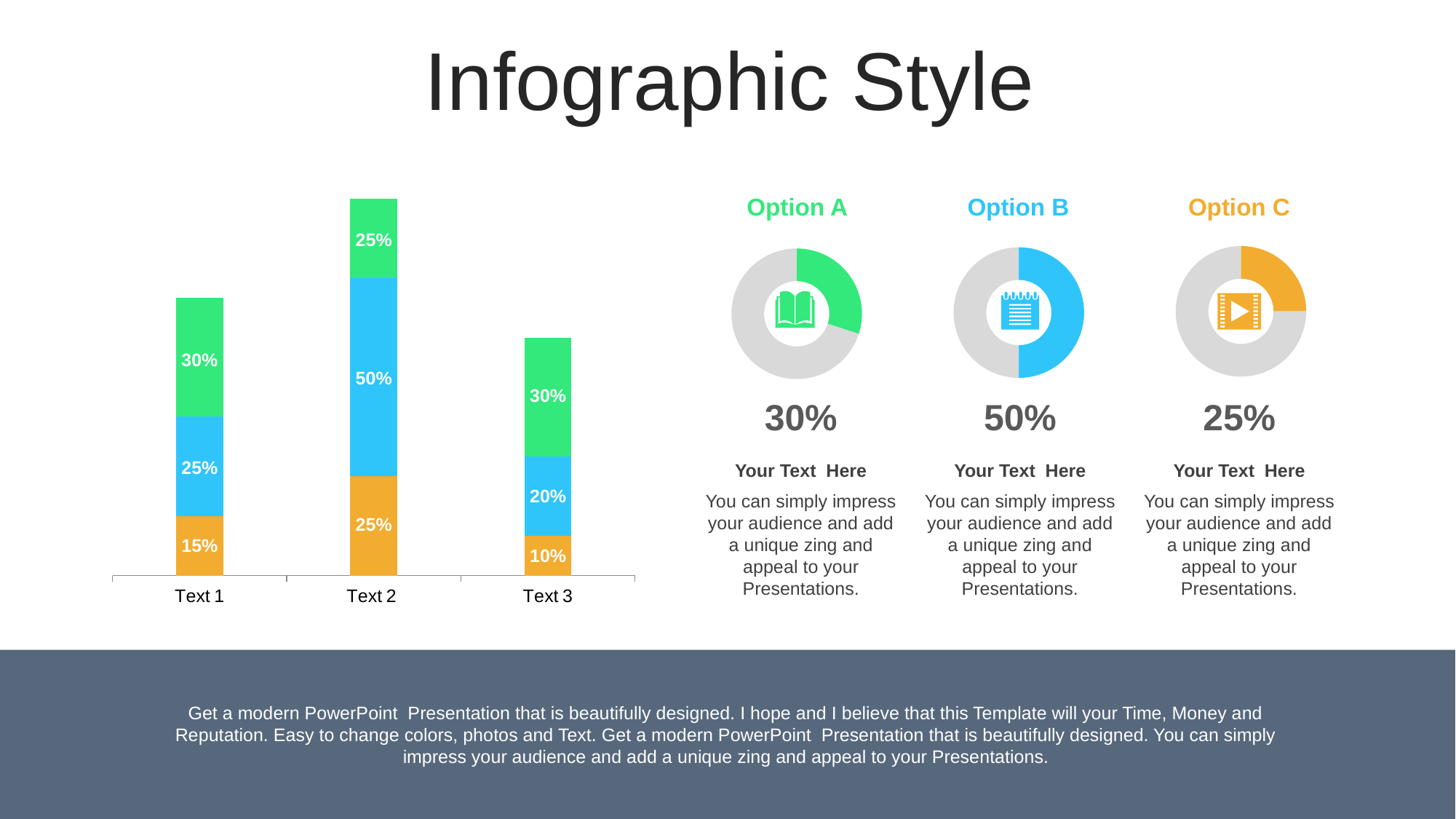
In the stacked bar chart, which category has the shortest bar? Text 3 In the stacked bar chart, what is the value of the green segment for Text 3? 30% In the stacked bar chart, what is the value of the blue segment for Text 2? 50% In the stacked bar chart, which category has the tallest bar? Text 2 In the stacked bar chart, what is the difference between the blue segment of Text 2 and the blue segment of Text 3? 30% What kind of chart is shown on the left of the slide? Stacked bar chart In the stacked bar chart, what is the value of the orange segment for Text 1? 15% In the stacked bar chart, how many categories are shown on the x axis? 3 What percentage is shown for the Option B donut chart? 50% In the stacked bar chart, is the orange segment larger for Text 2 or Text 3? Text 2 In the stacked bar chart, what is the total of the stacked bar for Text 1? 70% In the stacked bar chart, what is the total of the stacked bar for Text 3? 60%